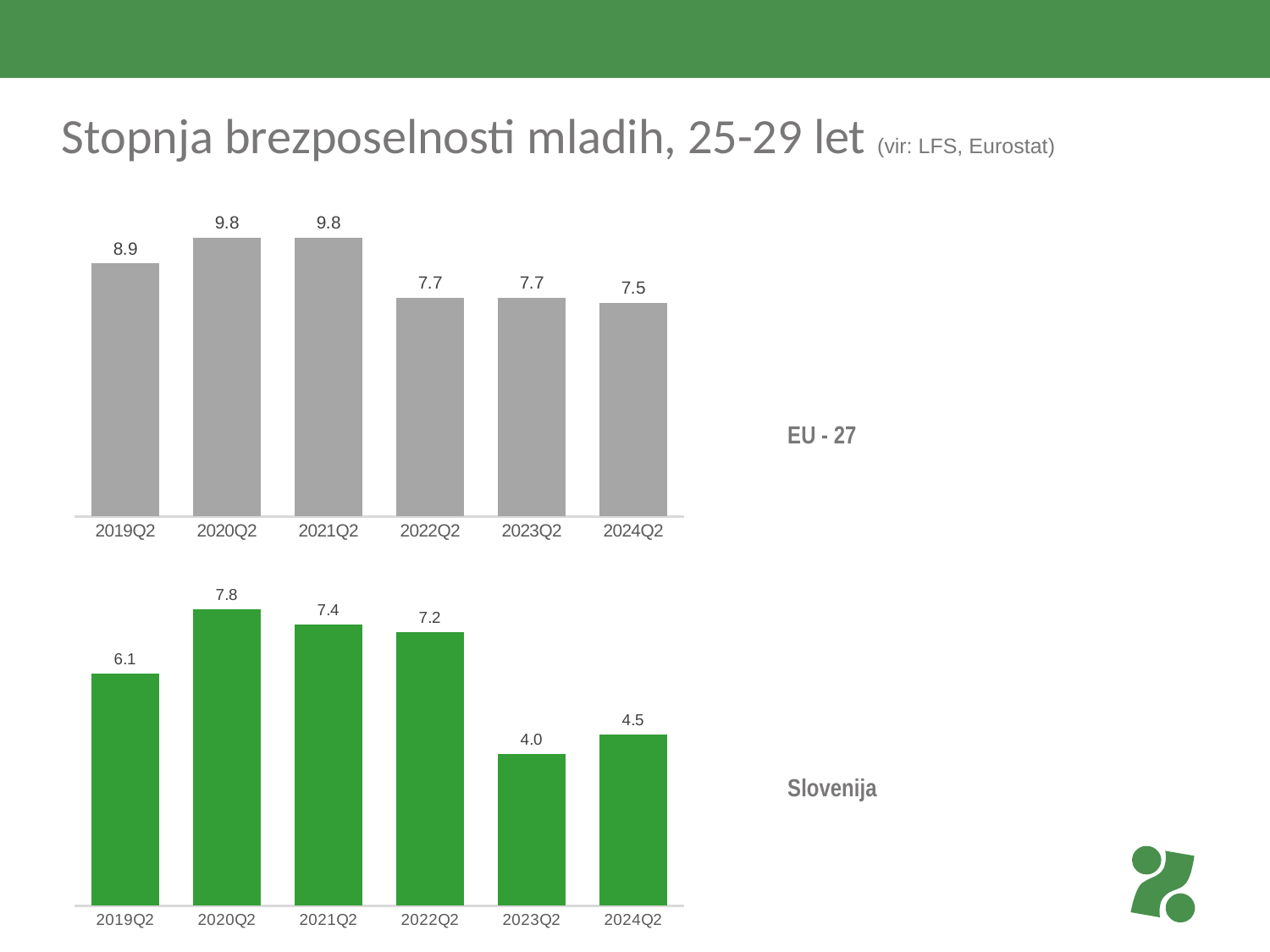
In the Slovenija chart (bottom), which is larger, the value for 2019Q2 or the value for 2024Q2? 2019Q2 In the EU - 27 chart (top), do the values rise or fall from 2021Q2 to 2024Q2? Fall In the EU - 27 chart (top), what is the difference between the values for 2021Q2 and 2024Q2? 2.3 In the Slovenija chart (bottom), what is the value for 2023Q2? 4.0 In the Slovenija chart (bottom), which quarter has the lowest value? 2023Q2 How many quarters are shown on the x axis of the EU - 27 chart (top)? 6 In the Slovenija chart (bottom), which quarter has the highest value? 2020Q2 What is the title of the slide? Stopnja brezposelnosti mladih, 25-29 let In the Slovenija chart (bottom), what is the difference between the values for 2020Q2 and 2023Q2? 3.8 In the EU - 27 chart (top), what is the value for 2019Q2? 8.9 In the EU - 27 chart (top), which quarter has the lowest value? 2024Q2 What kind of chart is the Slovenija chart (bottom)? Bar chart